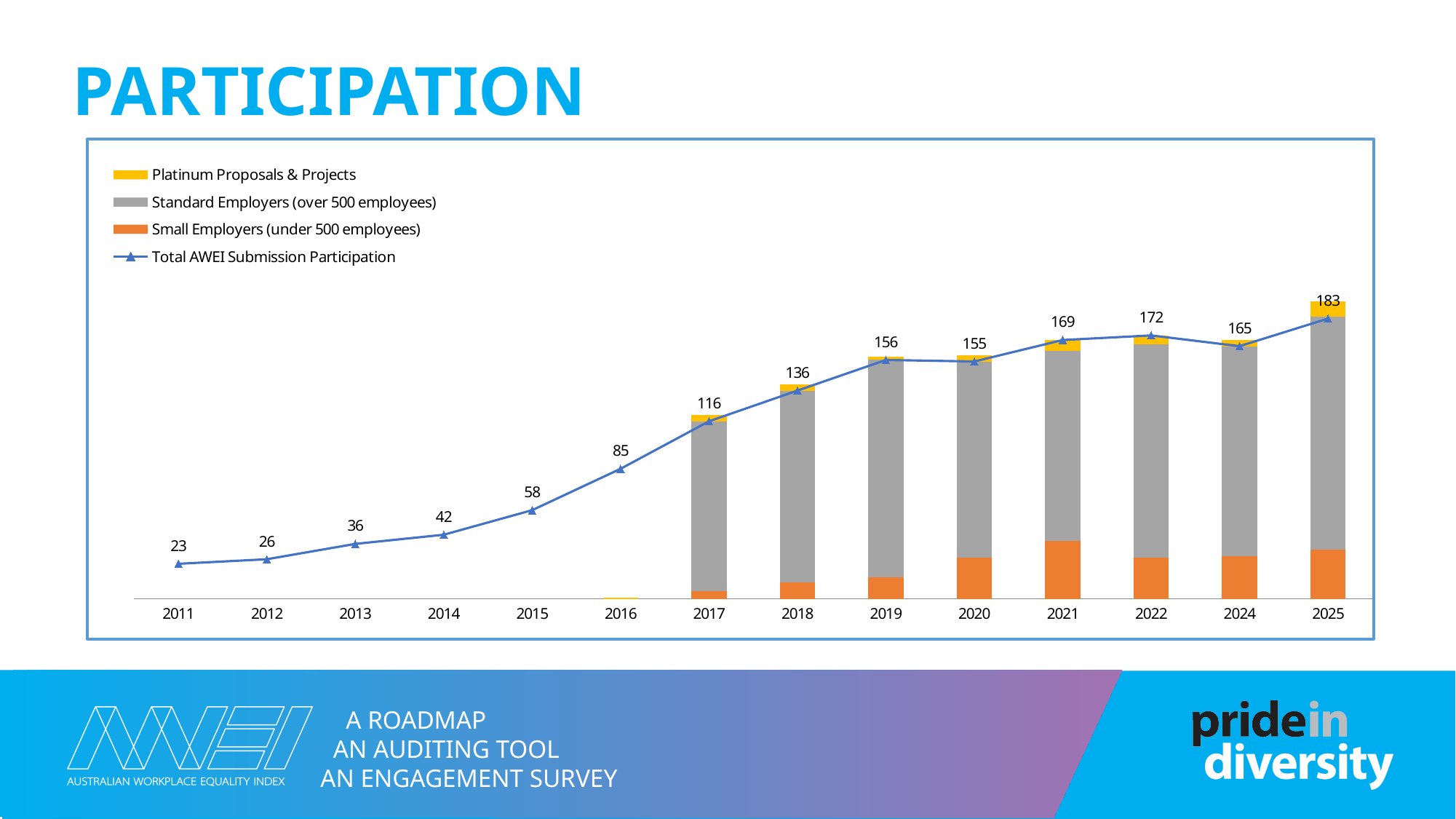
What is the Total AWEI Submission Participation value for 2019? 156 What is the difference in Total AWEI Submission Participation between 2025 and 2024? 18 How many series does the legend list? 4 What is the Total AWEI Submission Participation value for 2024? 165 Does the Total AWEI Submission Participation line generally rise or fall from 2011 to 2025? rise Which year has the lowest Total AWEI Submission Participation? 2011 What is the Total AWEI Submission Participation value for 2011? 23 Which year has a larger Total AWEI Submission Participation, 2020 or 2022? 2022 How many years are shown on the x axis of the chart? 14 What is the difference in Total AWEI Submission Participation between 2017 and 2016? 31 Which year has the highest Total AWEI Submission Participation? 2025 Which legend entry is shown in orange? Small Employers (under 500 employees)